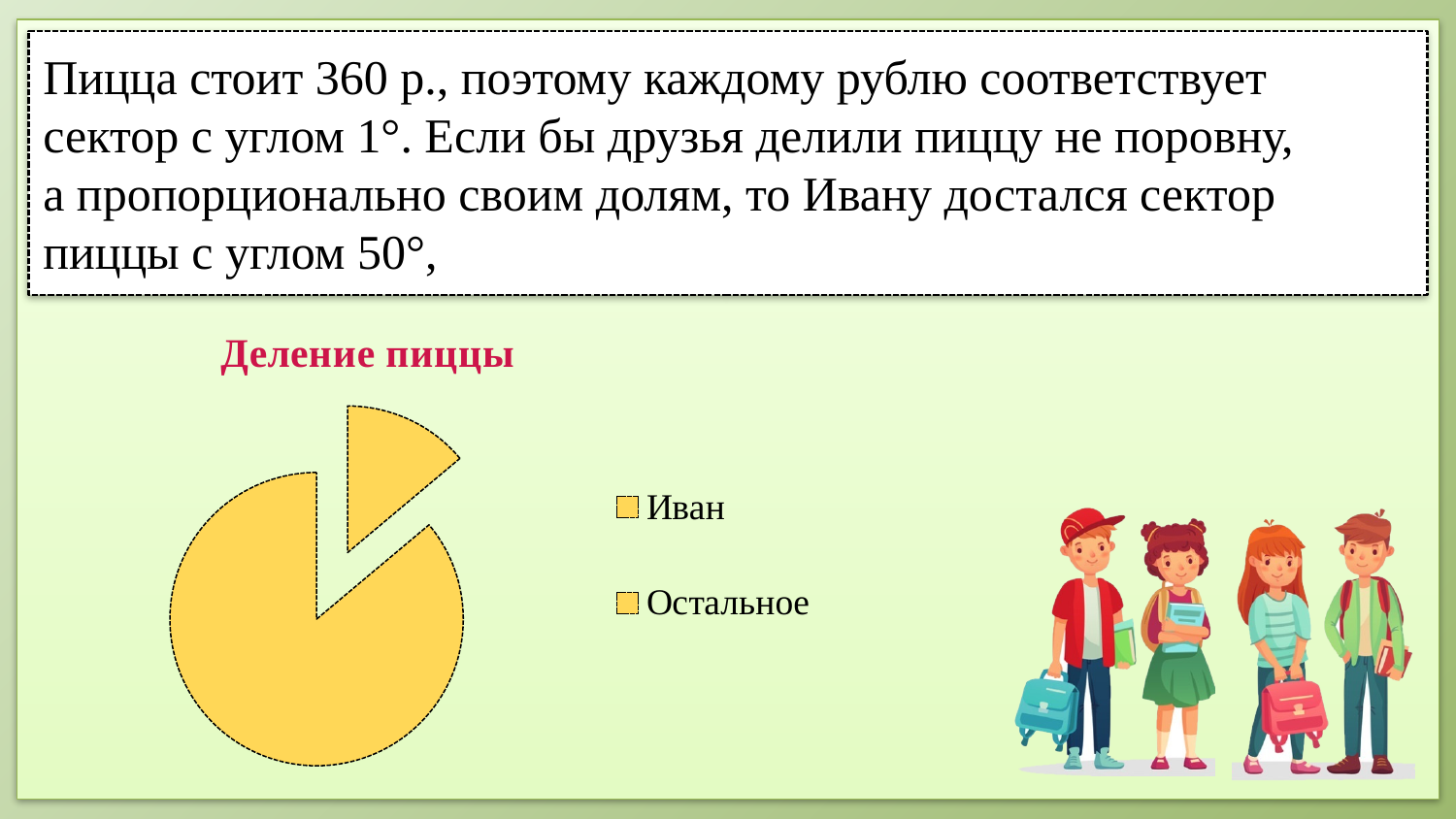
Which slice of the pie chart is the smallest? Иван What kind of chart is shown on the slide? pie chart What is the title of the chart? Деление пиццы Which slice of the pie chart is pulled out (exploded) from the rest? Иван Which slice of the pie chart is the largest? Остальное How many entries does the legend list? 2 Which slice is larger, Иван or Остальное? Остальное How many slices does the pie chart have? 2 What are the two legend entries of the chart? Иван, Остальное